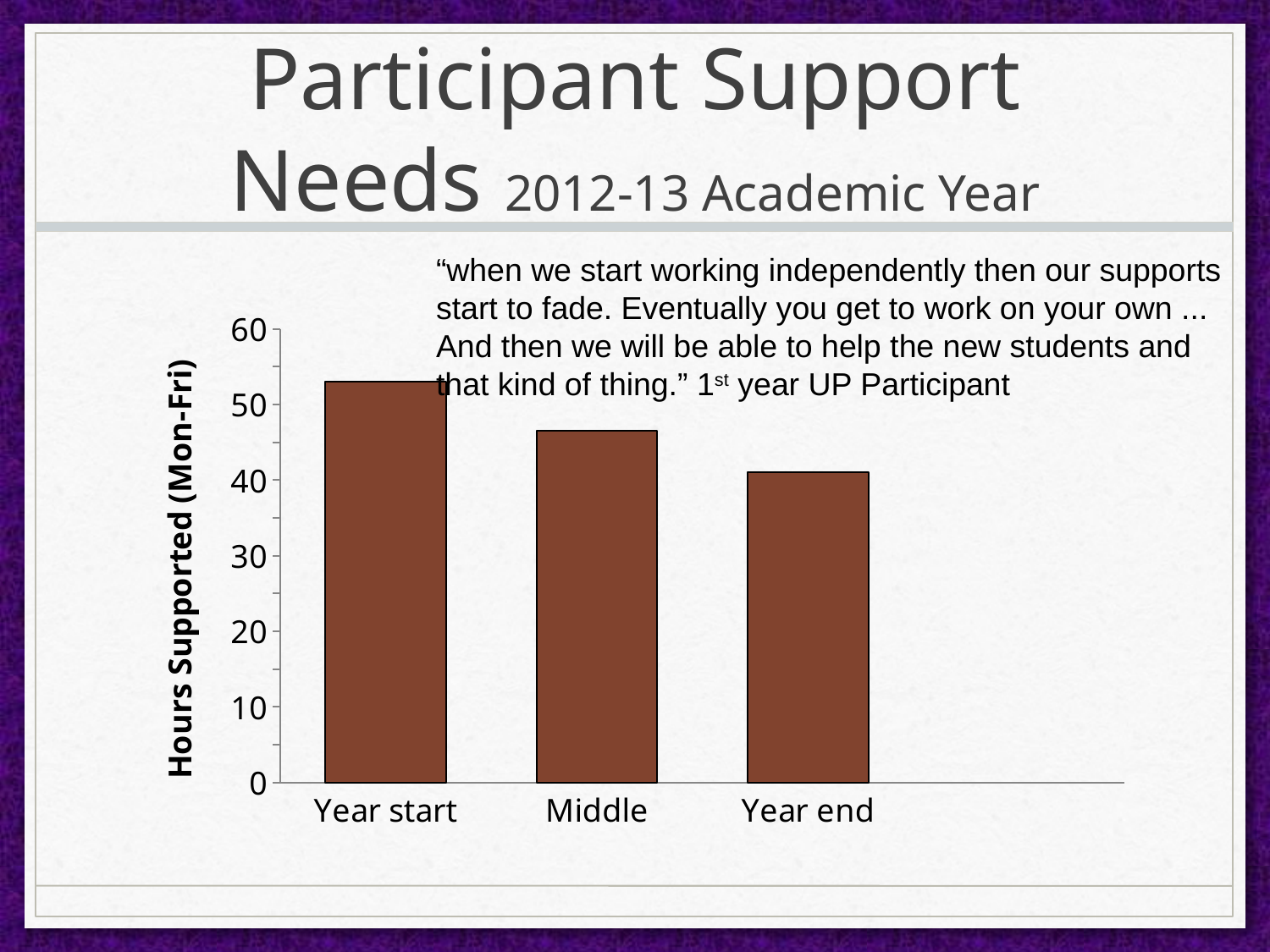
Is the value for Year end greater or less than 50? less What is the title of the vertical axis of the chart? Hours Supported (Mon-Fri) Do the values rise or fall from Year start to Year end? fall Is the value for Middle greater or less than 50? less Which is larger, the value for Middle or the value for Year end? Middle How many categories are plotted on the x axis of the chart? 3 What kind of chart is shown on the slide? bar chart Which category has the lowest number of hours supported? Year end Which category has the highest number of hours supported? Year start Which is larger, the value for Year start or the value for Middle? Year start Is the value for Year start greater or less than 50? greater